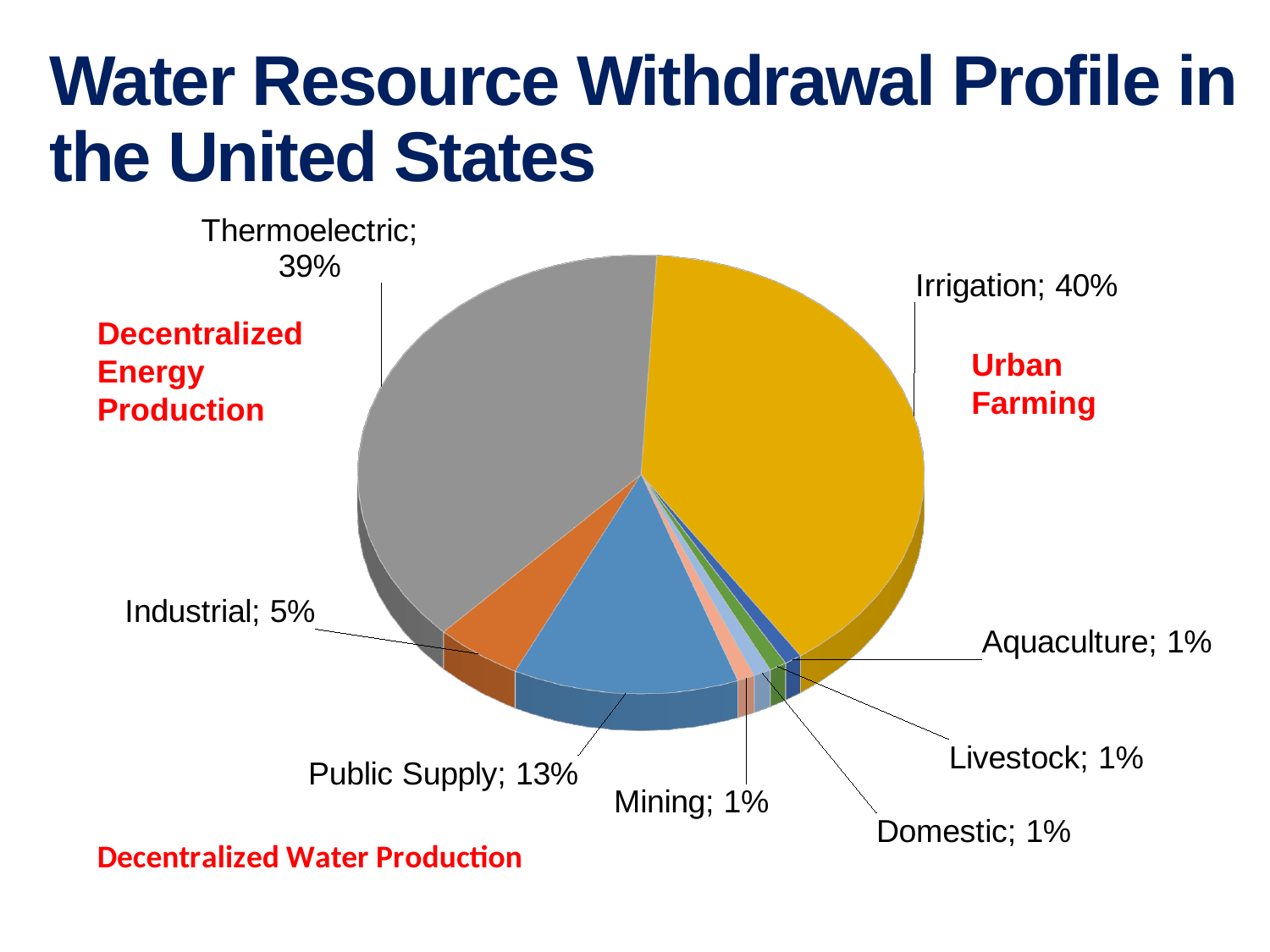
How many categories are shown in the pie chart? 8 Which category has the largest share of the pie? Irrigation What is the title of the slide? Water Resource Withdrawal Profile in the United States What is the value shown for Mining? 1% What kind of chart is shown on the slide? Pie chart What is the difference between the Irrigation share and the Public Supply share? 27% What is the value shown for Public Supply? 13% What is the value shown for Industrial? 5% Which is larger, the share for Irrigation or the share for Thermoelectric? Irrigation What is the difference between the Public Supply share and the Industrial share? 8% What is the value shown for Thermoelectric? 39% What share of the pie does Irrigation account for? 40%